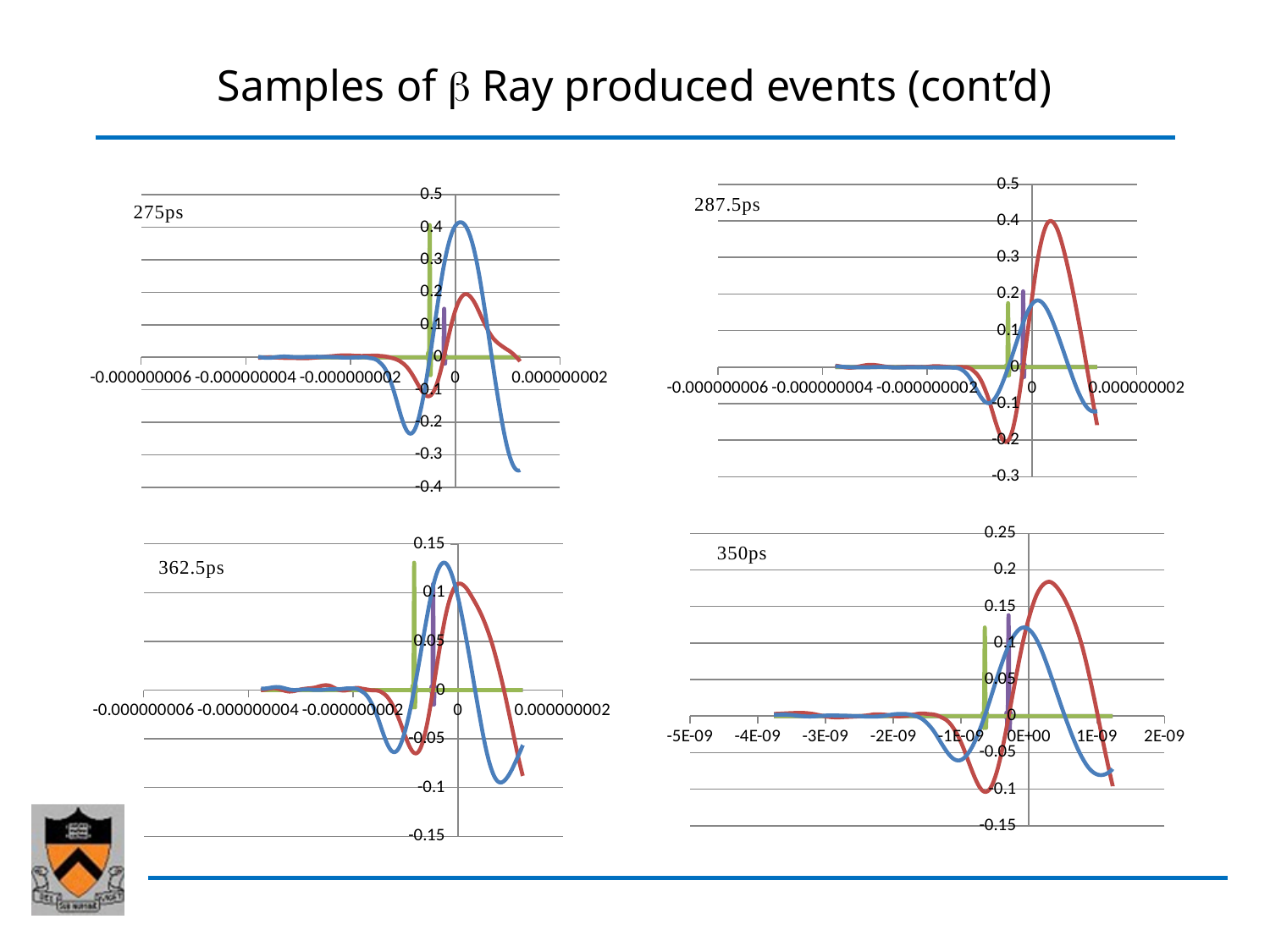
What is the highest value shown on the vertical axis of the chart labelled 362.5ps? 0.15 In the chart labelled 350ps, is the peak value of the red line greater or less than 0.15? greater In the chart labelled 275ps, is the lowest value of the blue line greater or less than -0.3? less What kind of chart is the one labelled 275ps? line chart In the chart labelled 350ps, which line reaches the higher peak, the blue line or the red line? red In the chart labelled 275ps, is the peak value of the blue line greater or less than 0.3? greater What is the label shown on the bottom-right chart? 350ps In the chart labelled 287.5ps, which line reaches the higher peak, the blue line or the red line? red In the chart labelled 275ps, which line reaches the higher peak, the blue line or the red line? blue How many charts are shown on the slide? 4